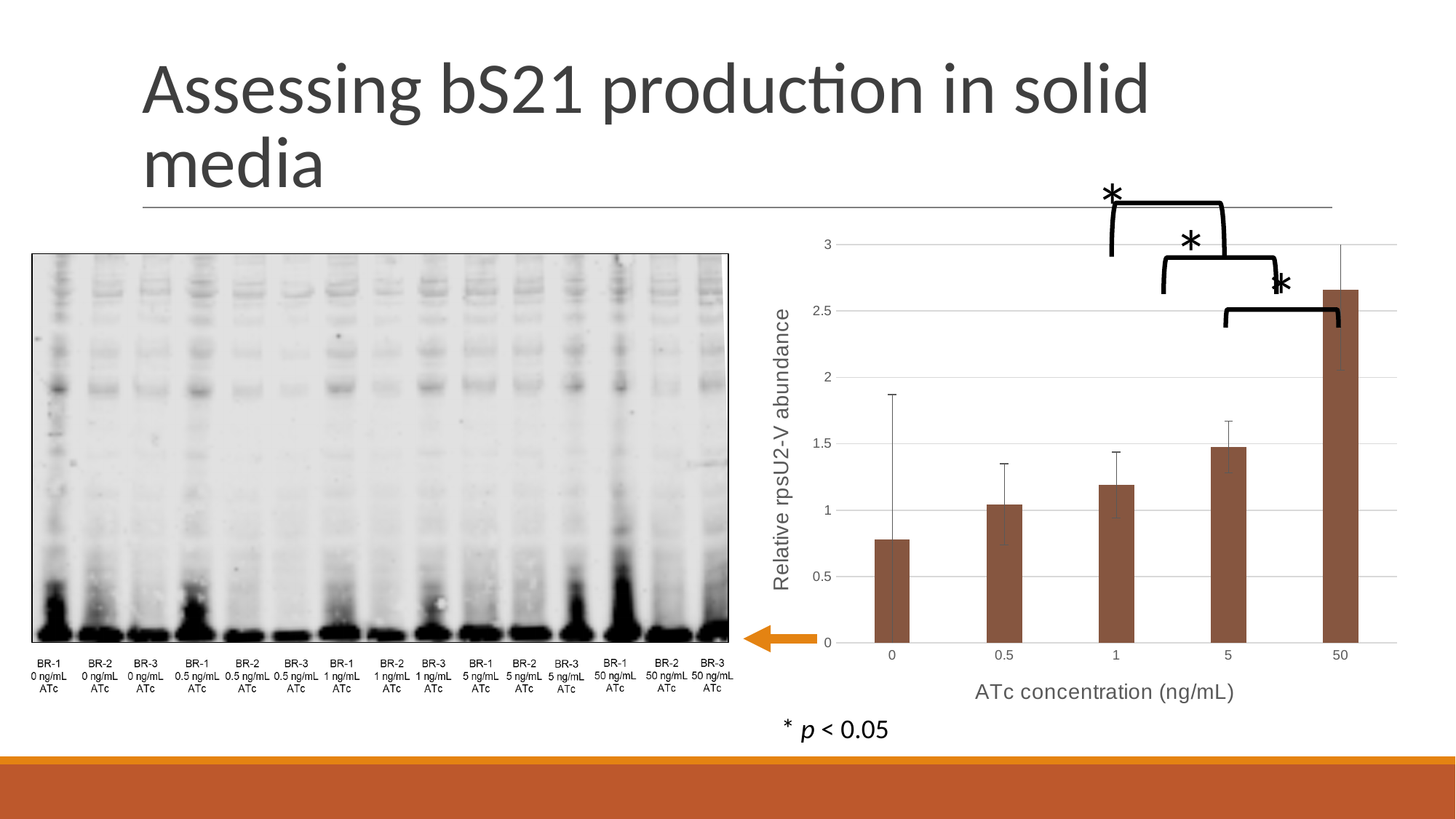
Which ATc concentration has the highest relative rpsU2-V abundance? 50 Which ATc concentration has the lowest relative rpsU2-V abundance? 0 Is the relative rpsU2-V abundance at 50 ng/mL ATc greater or less than 2.5? greater Is the relative rpsU2-V abundance at 0 ng/mL ATc greater or less than 1? less What kind of chart is shown on the right of the slide? bar chart How many ATc concentration categories are plotted in the bar chart? 5 What is the y-axis title of the bar chart? Relative rpsU2-V abundance Does the relative rpsU2-V abundance rise or fall as ATc concentration increases along the x axis? rise Is the relative rpsU2-V abundance at 50 ng/mL ATc greater or less than 2? greater What is the x-axis title of the bar chart? ATc concentration (ng/mL) Which has a larger relative rpsU2-V abundance, 5 ng/mL or 50 ng/mL ATc? 50 ng/mL